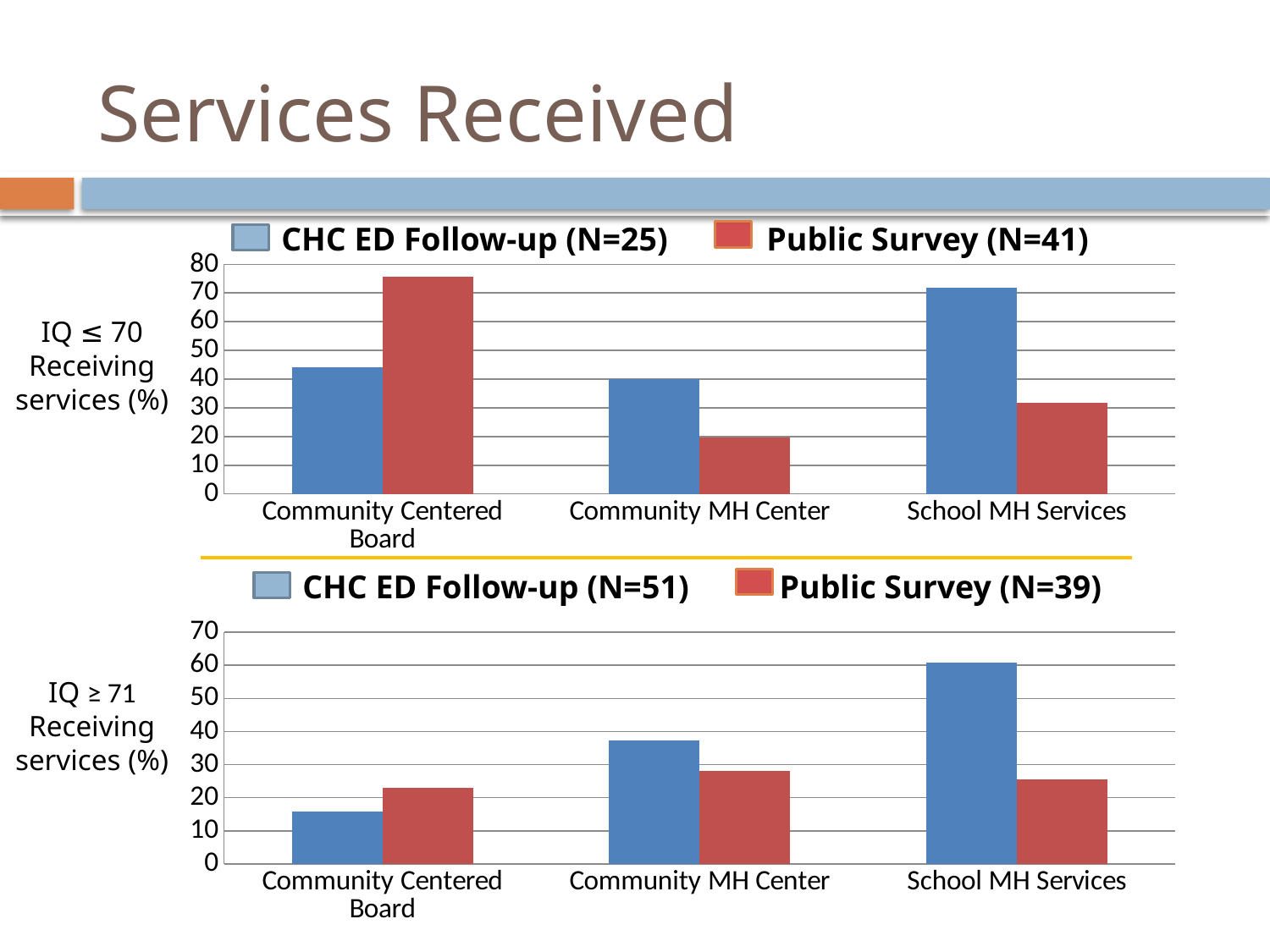
What kind of chart is the top chart (IQ ≤ 70 Receiving services)? Bar chart In the top chart (IQ ≤ 70), which category has the highest CHC ED Follow-up (N=25) bar? School MH Services In the top chart (IQ ≤ 70), which category has the highest Public Survey (N=41) bar? Community Centered Board In the bottom chart (IQ ≥ 71), which category has the lowest CHC ED Follow-up (N=51) bar? Community Centered Board In the top chart (IQ ≤ 70), how many service categories are shown on the x axis? 3 In the top chart (IQ ≤ 70), is the Public Survey value for Community MH Center greater or less than 30? less In the bottom chart (IQ ≥ 71), what sample size does the legend give for the Public Survey series? N=39 In the top chart (IQ ≤ 70), how many series does the legend list? 2 In the top chart (IQ ≤ 70), is the CHC ED Follow-up value for School MH Services greater or less than 60? greater In the top chart (IQ ≤ 70), for Community Centered Board, which series has the larger value? Public Survey (N=41) In the bottom chart (IQ ≥ 71), which category has the highest CHC ED Follow-up (N=51) bar? School MH Services In the bottom chart (IQ ≥ 71), is the CHC ED Follow-up value for School MH Services greater or less than 50? greater